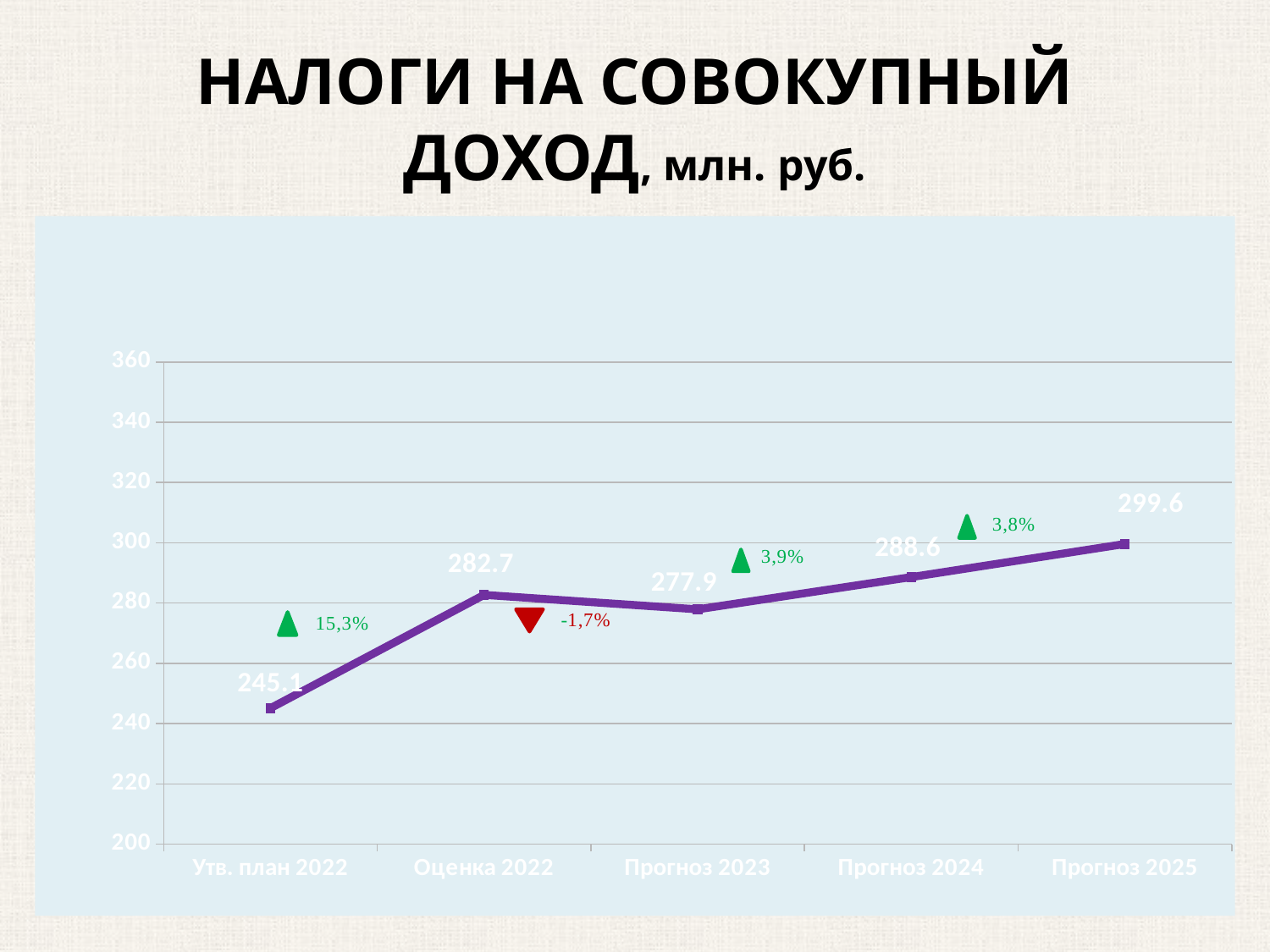
What is the value for Прогноз 2025? 299.6 What is the value for Прогноз 2023? 277.9 What is the value for Утв. план 2022? 245.1 Which category has the highest value? Прогноз 2025 What percentage change is shown between Оценка 2022 and Прогноз 2023? -1,7% Is the value for Утв. план 2022 greater or less than 260? less How many categories are plotted on the x axis? 5 What kind of chart is shown on the slide? line chart What is the difference between the values for Прогноз 2025 and Прогноз 2024? 11.0 Which is larger, the value for Оценка 2022 or the value for Прогноз 2023? Оценка 2022 Which category has the lowest value? Утв. план 2022 What is the value for Оценка 2022? 282.7